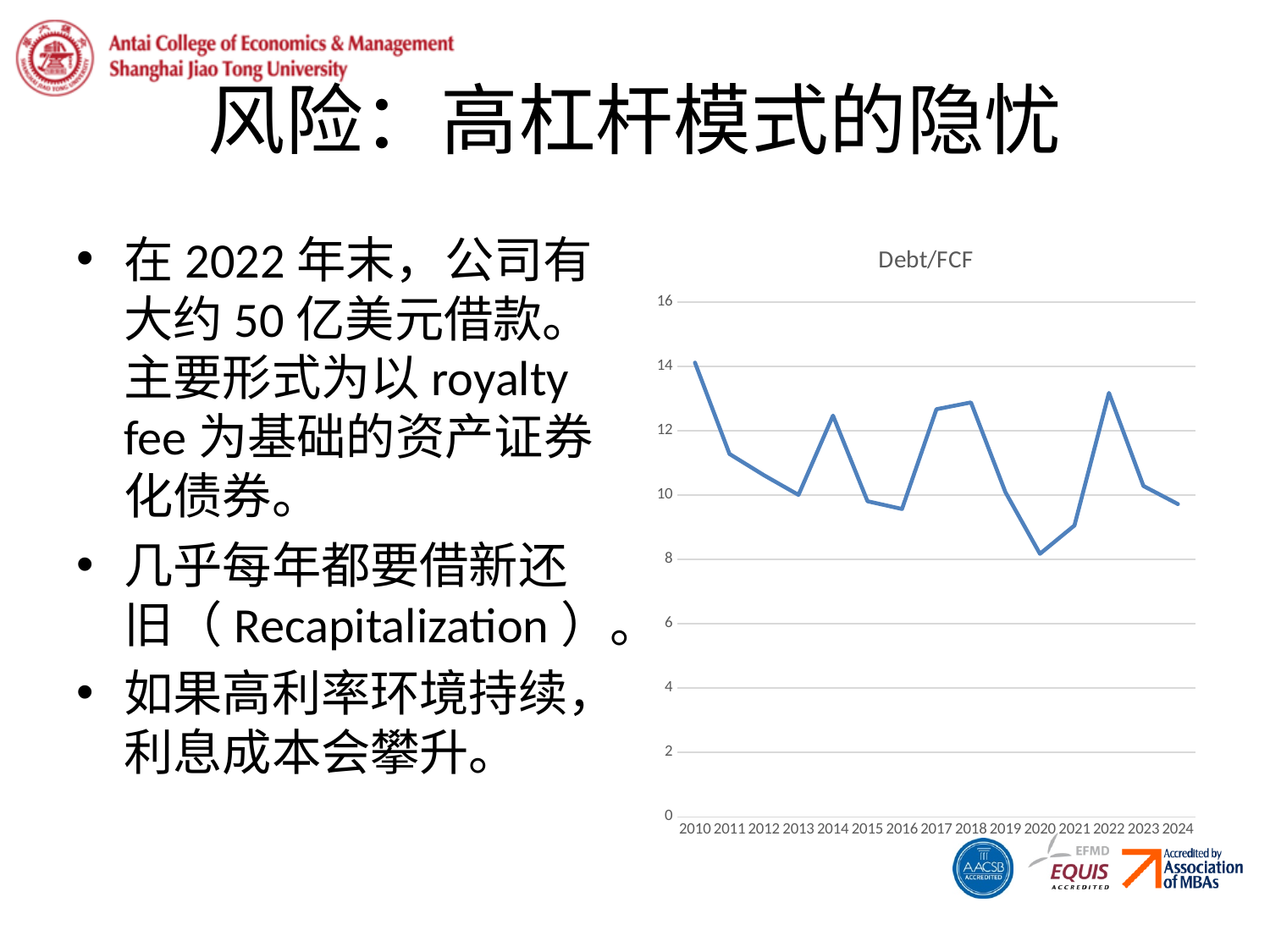
How many years are plotted on the x axis of the Debt/FCF chart? 15 What kind of chart is shown on the slide? line chart Which year has a higher Debt/FCF value, 2010 or 2022? 2010 Is the Debt/FCF value for 2010 greater or less than 12? greater Is the Debt/FCF value for 2022 greater or less than 12? greater Which year has the lowest Debt/FCF value? 2020 Overall, does the Debt/FCF value rise or fall from 2010 to 2024? fall Is the Debt/FCF value for 2016 greater or less than 10? less What is the title of the chart? Debt/FCF Which year has the highest Debt/FCF value? 2010 Which year has a higher Debt/FCF value, 2014 or 2020? 2014